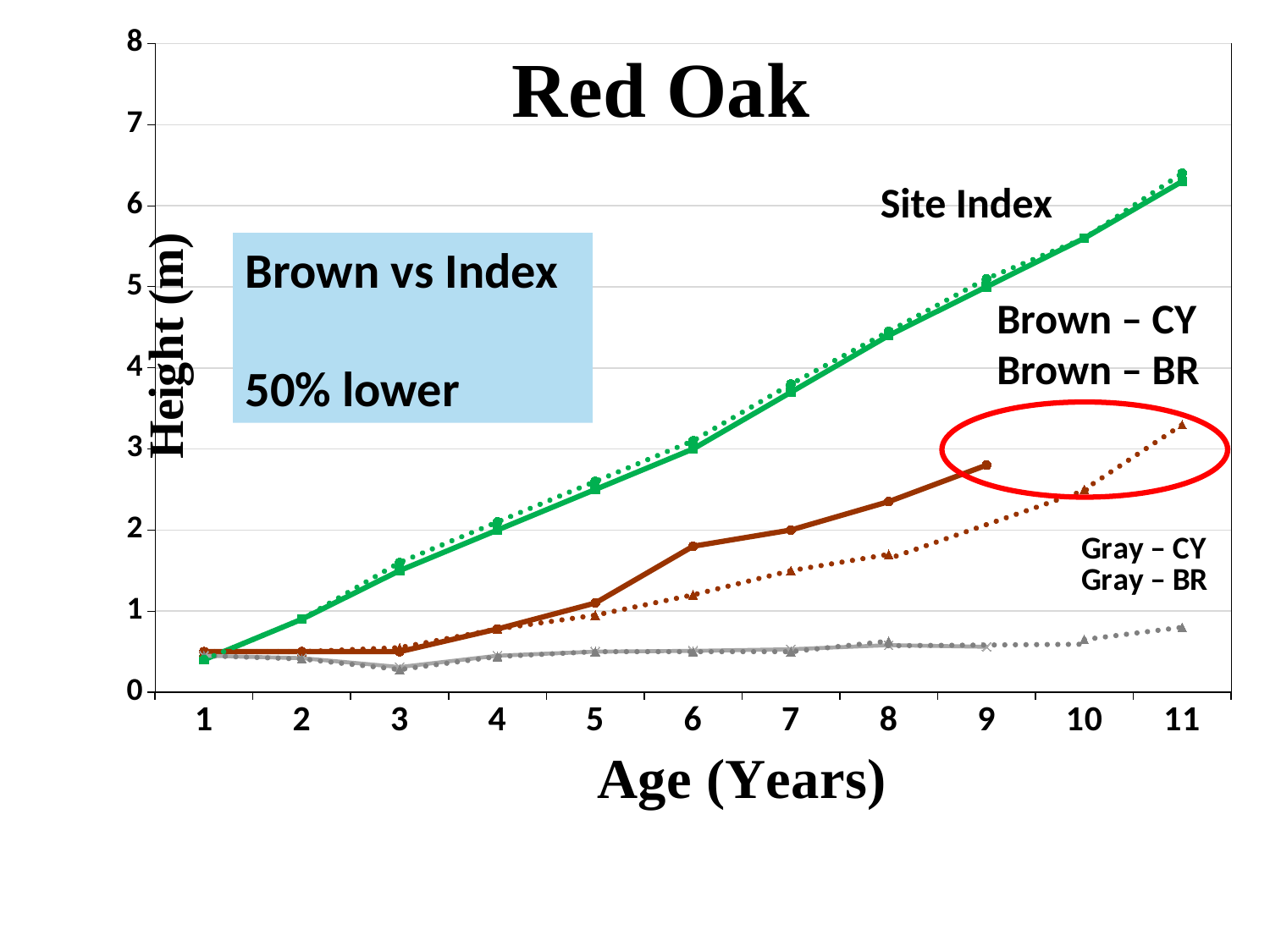
Is the Site Index height at age 8 greater or less than 4? greater At age 9, which is higher: the Site Index line or the Brown – CY line? Site Index Which series reaches the greatest height at age 11? Site Index Is the Site Index height at age 11 greater or less than 6? greater What kind of chart is shown on the slide? line chart Is the Brown – CY height at age 6 greater or less than 1? greater What is the label of the x axis of the chart? Age (Years) How many age values are shown along the x axis of the chart? 11 What is the title of the chart? Red Oak Does the Site Index height rise or fall as age increases? rise